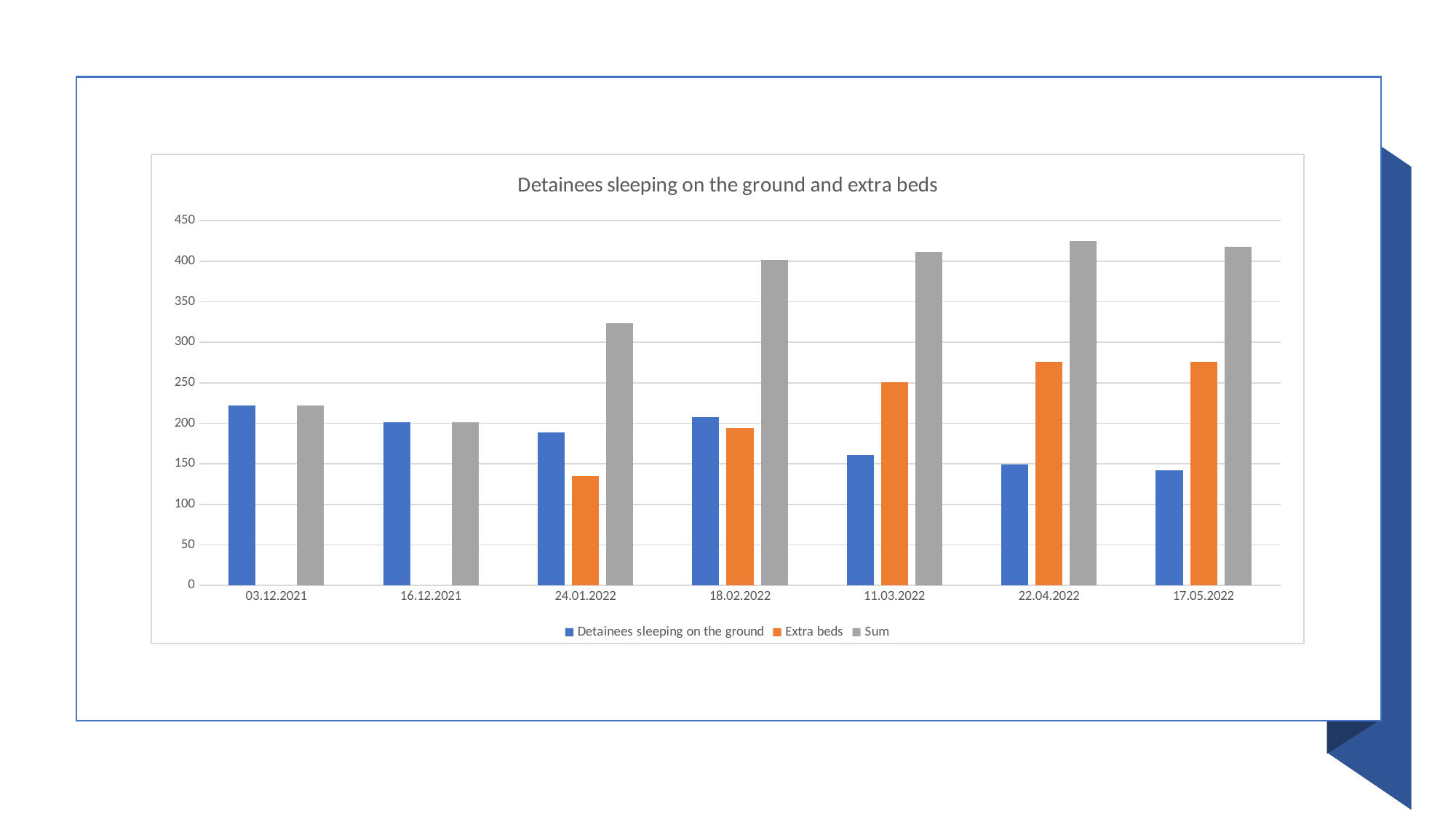
Is the Extra beds value for 11.03.2022 greater or less than 200? greater What kind of chart is shown on the slide? Bar chart How many dates are shown on the x axis? 7 Among the dates where an Extra beds bar is shown, which date has the lowest Extra beds value? 24.01.2022 On 11.03.2022, which is larger: Detainees sleeping on the ground or Extra beds? Extra beds What is the title of the chart? Detainees sleeping on the ground and extra beds Which date has the lowest value for Sum? 16.12.2021 Does the value for Detainees sleeping on the ground rise or fall from 18.02.2022 to 17.05.2022? Fall Is the Sum value for 24.01.2022 greater or less than 300? greater Is the value for Detainees sleeping on the ground on 03.12.2021 greater or less than 200? greater Which date has the highest value for Detainees sleeping on the ground? 03.12.2021 How many series does the legend list? 3